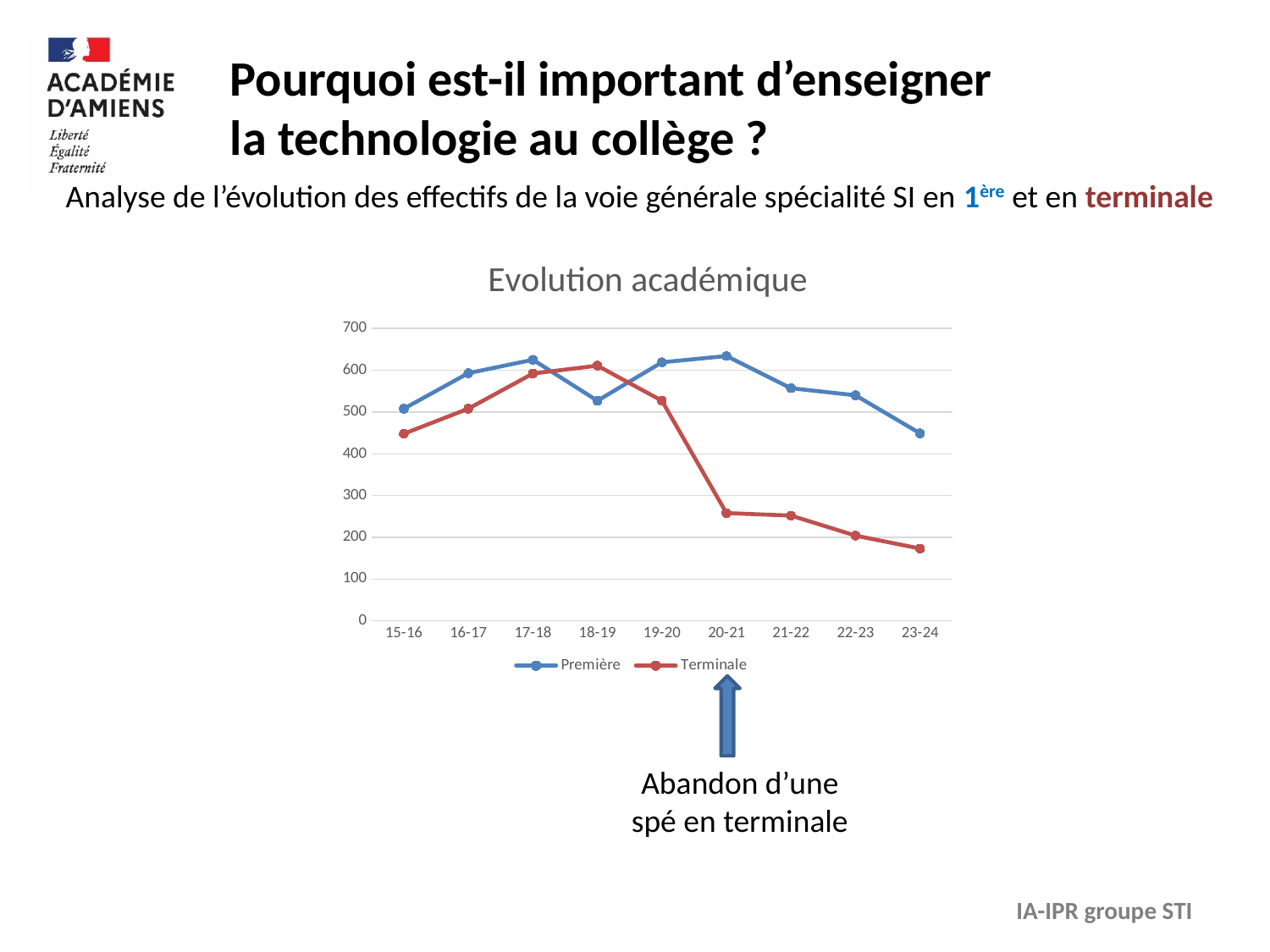
Does the Terminale series rise or fall from 19-20 to 23-24? fall What is the title of the chart? Evolution académique Is the value for Terminale in 20-21 greater or less than 300? less In 18-19, which series has the larger value, Première or Terminale? Terminale Which colour is used for the Terminale series in the chart? red Is the value for Première in 20-21 greater or less than 600? greater Is the value for Première in 23-24 greater or less than 500? less In which school year is the Terminale series at its lowest? 23-24 How many series does the legend of the chart list? 2 How many school years are plotted along the x axis of the chart? 9 What kind of chart is shown on the slide? line chart